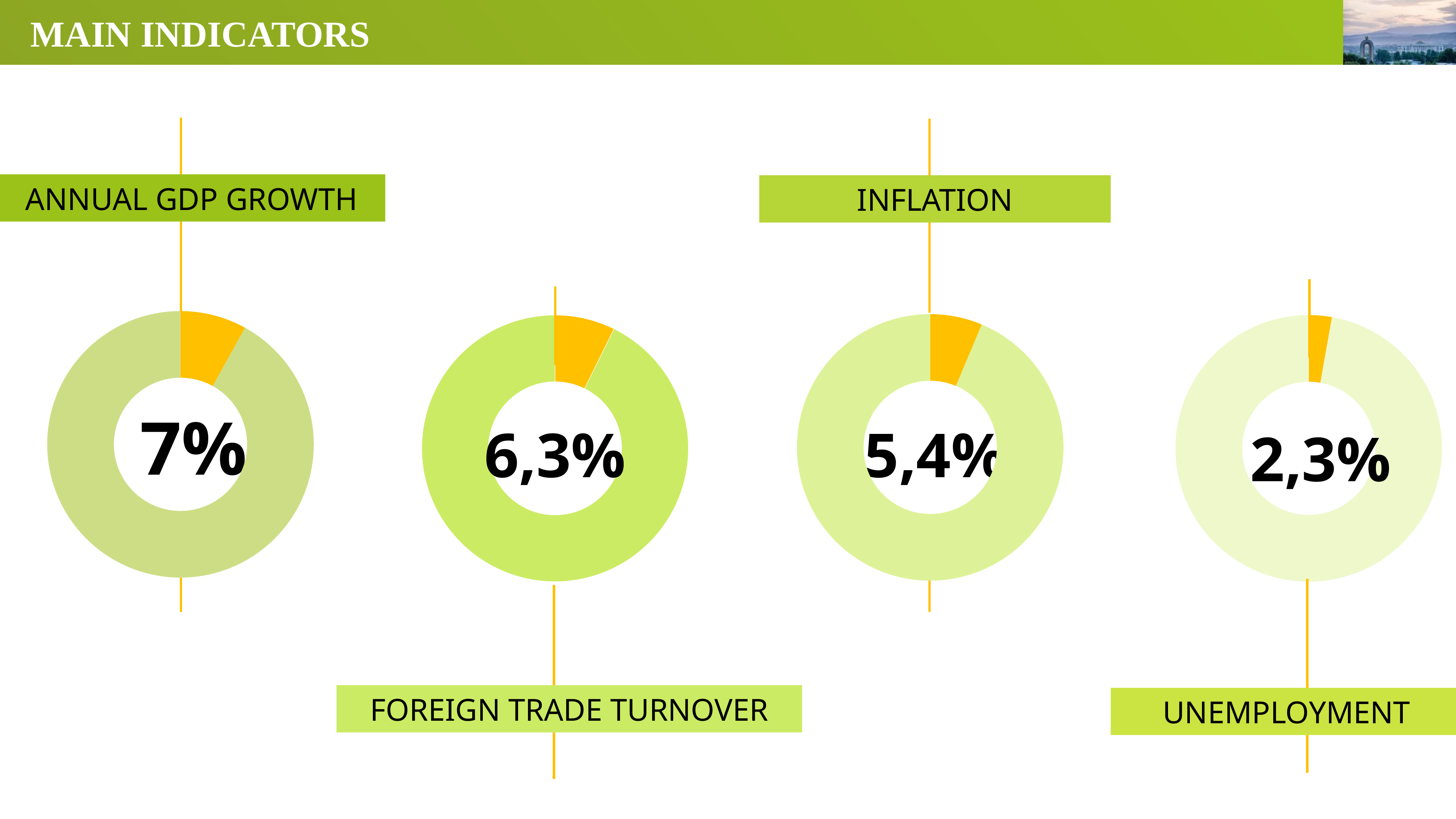
Which is larger, the Foreign Trade Turnover value or the Inflation value? Foreign Trade Turnover Which of the four indicators on the slide has the lowest value? Unemployment What value is shown in the Inflation donut chart? 5,4% What value is shown in the Unemployment donut chart? 2,3% What value is shown in the Foreign Trade Turnover donut chart? 6,3% What value is shown in the Annual GDP Growth donut chart? 7% What is the difference between the Annual GDP Growth value and the Unemployment value? 4,7% How many donut charts are shown on the slide? 4 What is the title of the slide? MAIN INDICATORS What kind of chart is used to display the Inflation indicator? Donut chart Which of the four indicators on the slide has the highest value? Annual GDP Growth What is the difference between the Foreign Trade Turnover value and the Inflation value? 0,9%